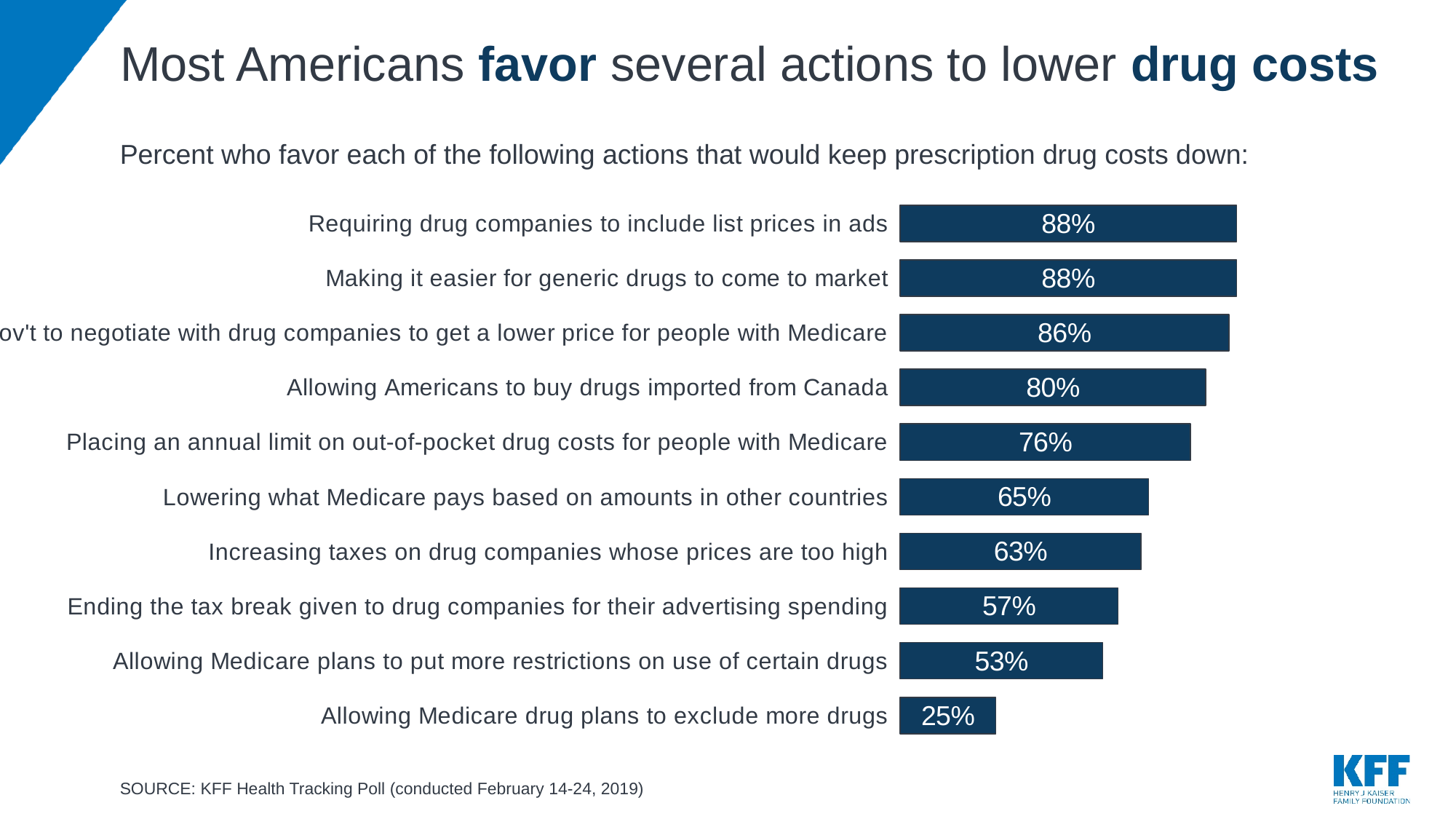
What is the difference between the percent favoring increasing taxes on drug companies whose prices are too high and the percent favoring allowing Medicare plans to put more restrictions on use of certain drugs? 10 percentage points What is the source of the data shown in the chart? KFF Health Tracking Poll (conducted February 14-24, 2019) What percent favor placing an annual limit on out-of-pocket drug costs for people with Medicare? 76% Which has a higher percent in favor: lowering what Medicare pays based on amounts in other countries, or increasing taxes on drug companies whose prices are too high? Lowering what Medicare pays based on amounts in other countries What percent favor allowing Americans to buy drugs imported from Canada? 80% Which action has the lowest percent in favor? Allowing Medicare drug plans to exclude more drugs What kind of chart is shown on the slide? Bar chart What percent favor allowing Medicare drug plans to exclude more drugs? 25% How many actions are shown in the chart? 10 What percent favor ending the tax break given to drug companies for their advertising spending? 57% What percent favor requiring drug companies to include list prices in ads? 88% What is the difference in percent favoring between making it easier for generic drugs to come to market and allowing Medicare drug plans to exclude more drugs? 63 percentage points